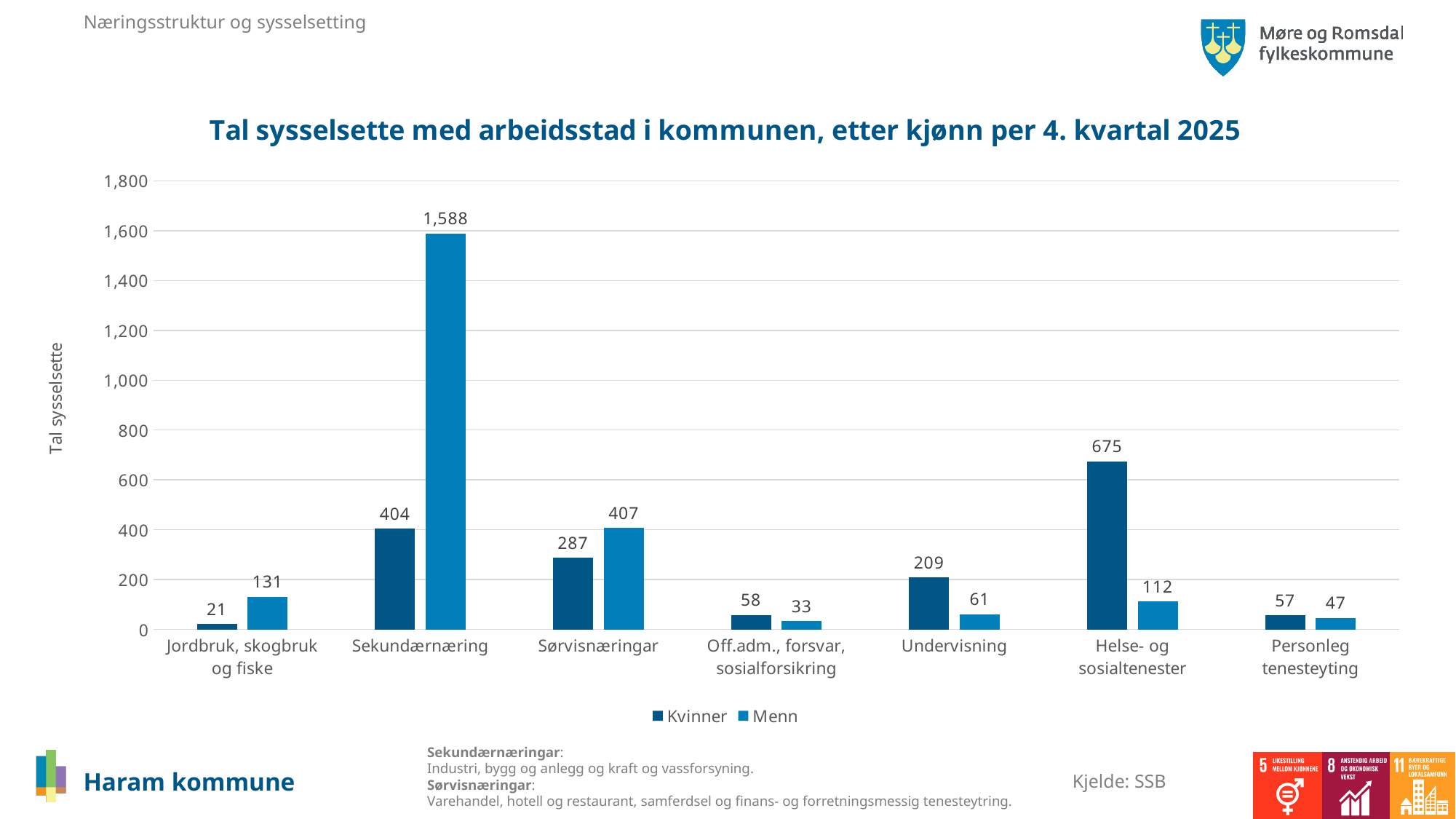
What kind of chart is shown on the slide? Bar chart How many categories are shown on the x axis? 7 Which is larger in Sørvisnæringar, Kvinner or Menn? Menn What is the value for Kvinner in Undervisning? 209 Which category has the highest value for Menn? Sekundærnæring What is the value for Menn in Sekundærnæring? 1,588 Is the value for Kvinner in Helse- og sosialtenester greater or less than 600? greater Which category has the lowest value for Kvinner? Jordbruk, skogbruk og fiske How many series does the legend list? 2 What is the value for Menn in Jordbruk, skogbruk og fiske? 131 What is the difference between Menn and Kvinner in Sekundærnæring? 1,184 What is the value for Kvinner in Helse- og sosialtenester? 675